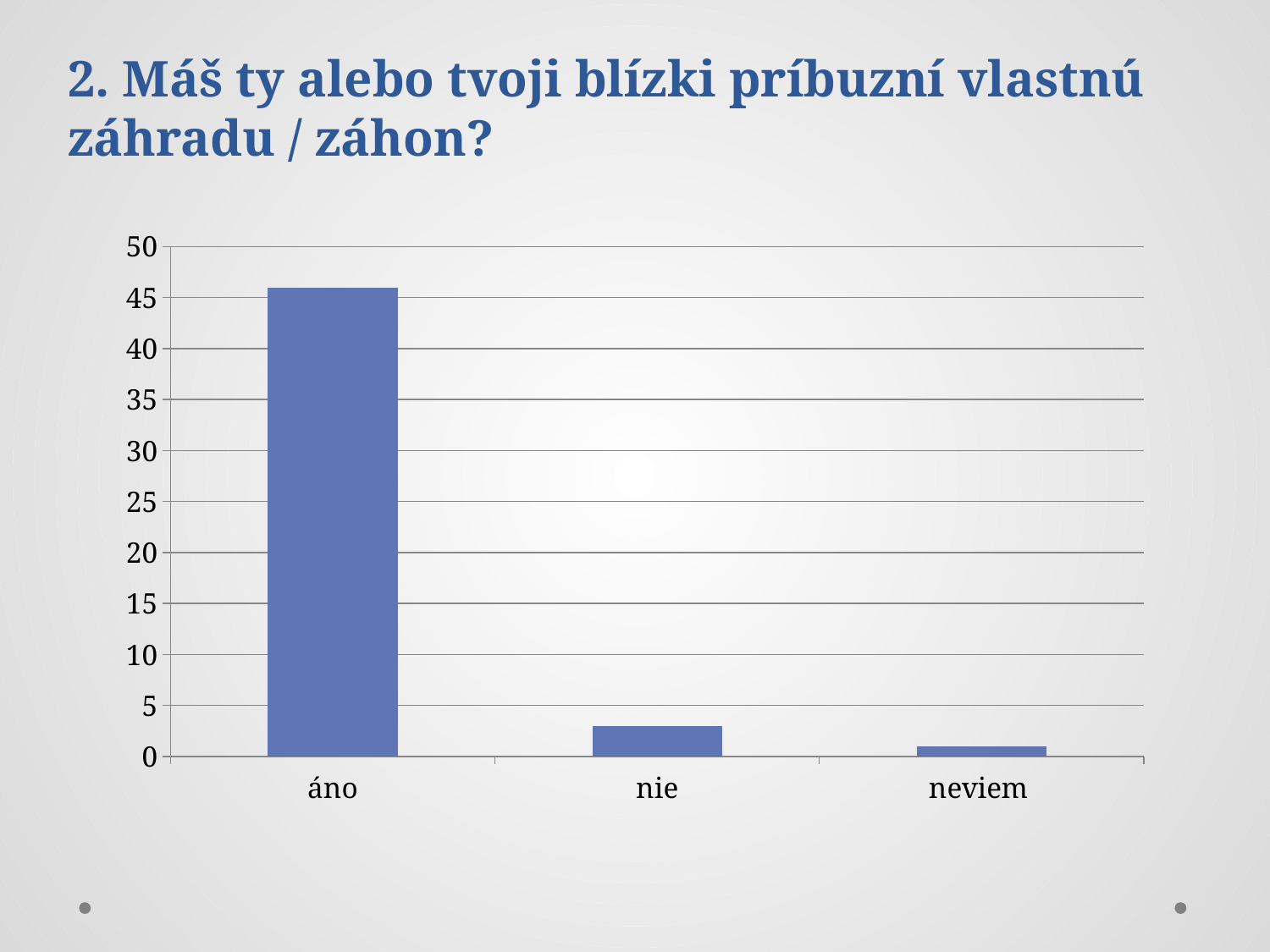
Which is larger, the value for nie or the value for neviem? nie Is the value for neviem greater or less than 5? less Is the value for áno greater or less than 50? less Which category has the lowest value in the chart? neviem Is the value for áno greater or less than 45? greater How many categories are shown on the x axis of the chart? 3 What kind of chart is shown on the slide? bar chart Which category has the highest value in the chart? áno Which is larger, the value for áno or the value for nie? áno What is the highest value shown on the vertical axis of the chart? 50 Do the values rise or fall from left to right along the x axis? fall